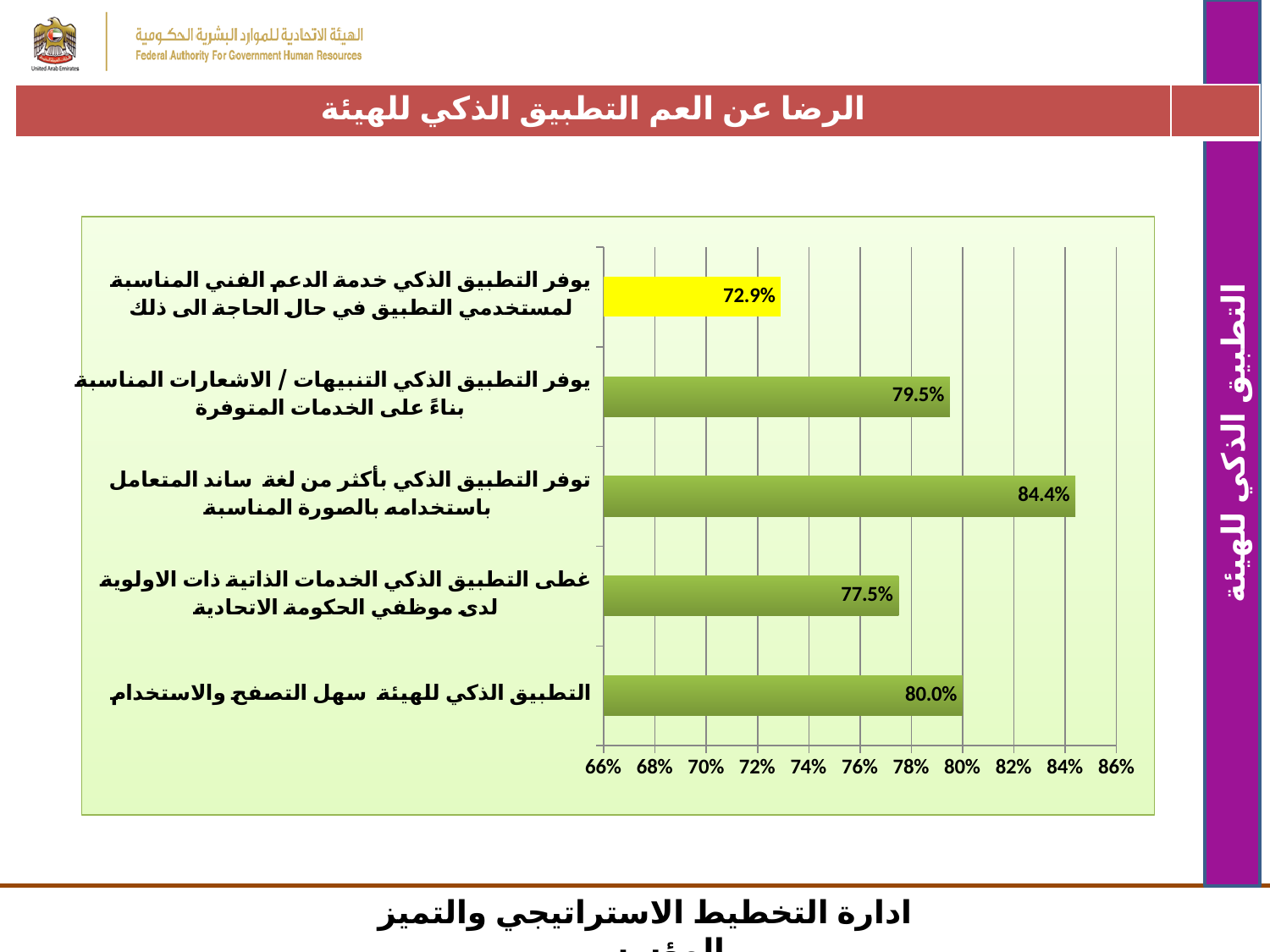
Which bar is highlighted in yellow rather than green? يوفر التطبيق الذكي خدمة الدعم الفني المناسبة لمستخدمي التطبيق في حال الحاجة الى ذلك How many categories are plotted in the chart? 5 Is the value for "يوفر التطبيق الذكي التنبيهات / الاشعارات المناسبة بناءً على الخدمات المتوفرة" greater or less than 78%? greater What is the value for "توفر التطبيق الذكي بأكثر من لغة ساند المتعامل باستخدامه بالصورة المناسبة"? 84.4% Which category has the lowest value? يوفر التطبيق الذكي خدمة الدعم الفني المناسبة لمستخدمي التطبيق في حال الحاجة الى ذلك What is the value for "غطى التطبيق الذكي الخدمات الذاتية ذات الاولوية لدى موظفي الحكومة الاتحادية"? 77.5% Which is larger: the value for "يوفر التطبيق الذكي التنبيهات / الاشعارات المناسبة بناءً على الخدمات المتوفرة" or the value for "غطى التطبيق الذكي الخدمات الذاتية ذات الاولوية لدى موظفي الحكومة الاتحادية"? يوفر التطبيق الذكي التنبيهات / الاشعارات المناسبة بناءً على الخدمات المتوفرة What is the value for "يوفر التطبيق الذكي خدمة الدعم الفني المناسبة لمستخدمي التطبيق في حال الحاجة الى ذلك"? 72.9% What is the value for "التطبيق الذكي للهيئة سهل التصفح والاستخدام"? 80.0% Which category has the highest value? توفر التطبيق الذكي بأكثر من لغة ساند المتعامل باستخدامه بالصورة المناسبة What type of chart is shown on the slide? bar chart What is the difference between the highest value (84.4%) and the lowest value (72.9%)? 11.5%